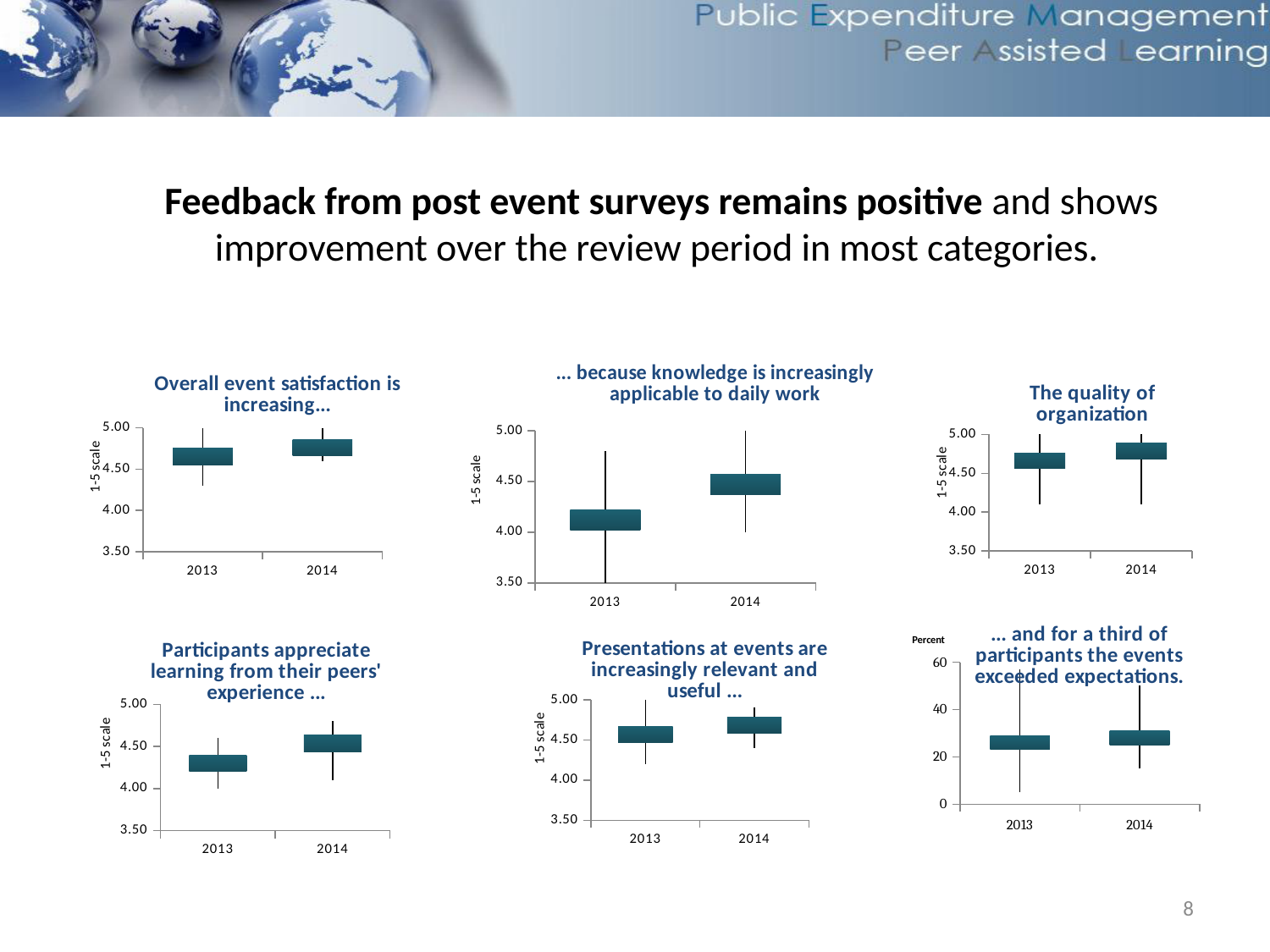
In the chart titled '... because knowledge is increasingly applicable to daily work', which year has the higher value, 2013 or 2014? 2014 In the chart titled '... and for a third of participants the events exceeded expectations.', is the value for 2014 greater or less than 20? greater In the chart titled 'Overall event satisfaction is increasing...', how many years are shown on the x axis? 2 In the chart titled '... and for a third of participants the events exceeded expectations.', is the value for 2013 greater or less than 40? less In the chart titled 'Presentations at events are increasingly relevant and useful ...', is the value for 2014 greater or less than 4.50? greater In the chart titled '... because knowledge is increasingly applicable to daily work', do the values rise or fall from 2013 to 2014? rise How many charts are shown on the slide? 6 What is the y-axis label of the chart titled 'The quality of organization'? 1-5 scale In the chart titled 'Participants appreciate learning from their peers' experience ...', which year has the higher value, 2013 or 2014? 2014